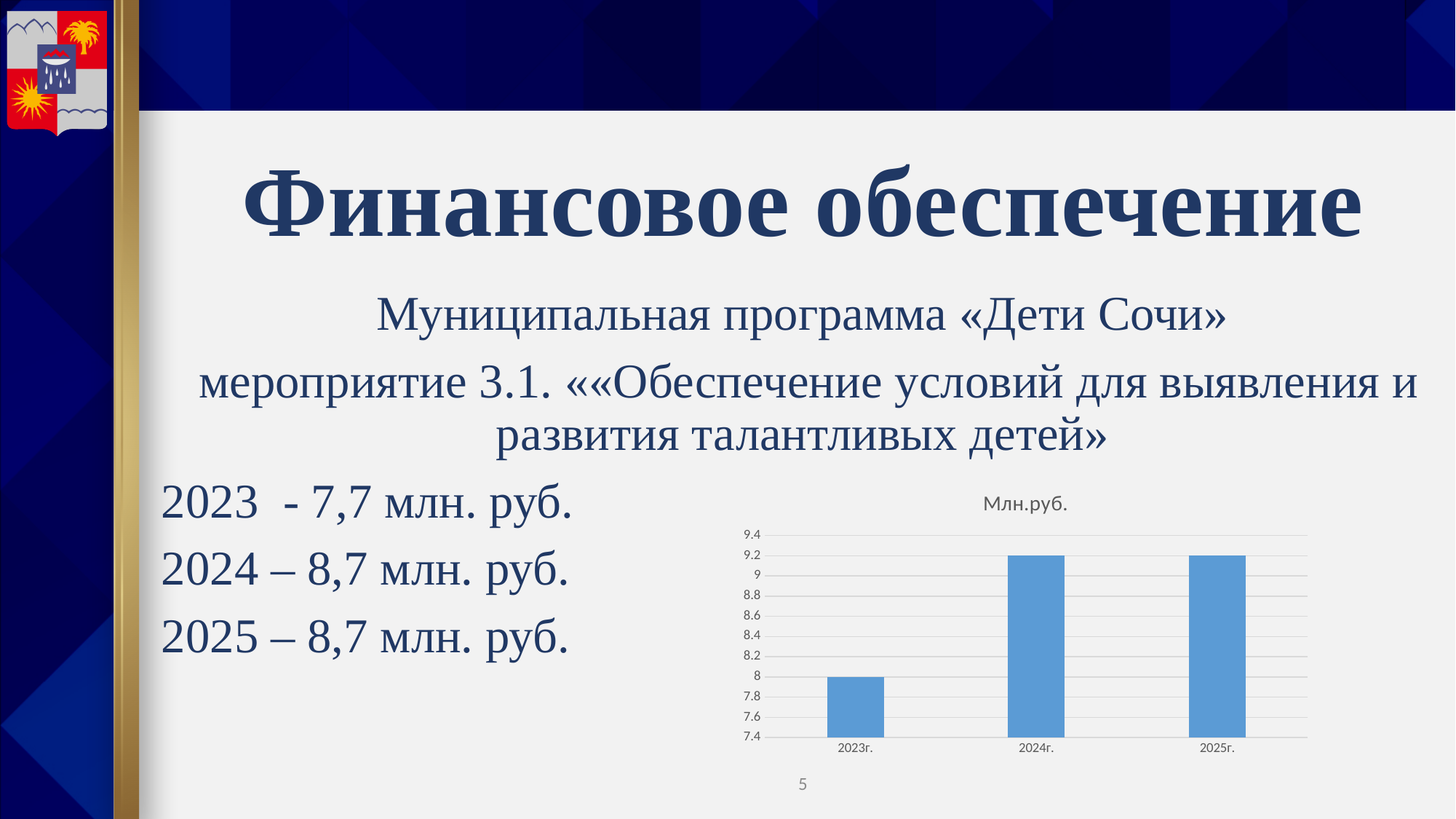
Which year has the lowest bar in the chart? 2023г. What kind of chart is shown on the slide? bar chart Does the value rise or fall from 2023г. to 2024г.? rise Is the bar for 2024г. greater or less than 9? greater How many bars (categories) does the chart show? 3 What is the title of the chart? Млн.руб. What is the lowest value shown on the vertical axis of the chart? 7.4 Which bar is taller, 2023г. or 2025г.? 2025г. Which bar is taller, 2023г. or 2024г.? 2024г. What is the highest value shown on the vertical axis of the chart? 9.4 Is the bar for 2025г. greater or less than 8.6? greater Is the bar for 2023г. greater or less than 9? less